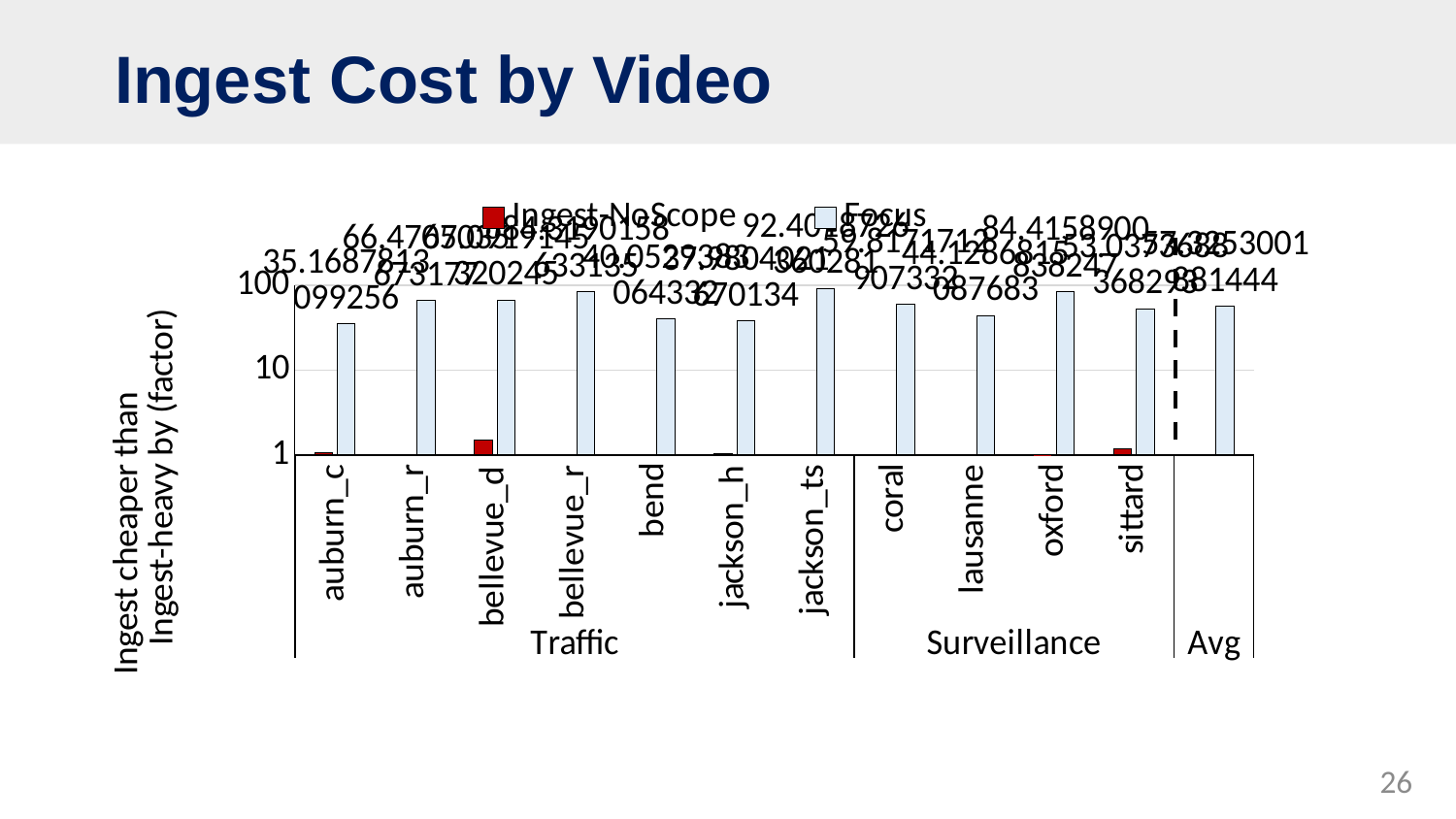
Is the Focus value for auburn_c greater or less than 100? less Which has the larger Focus value, auburn_r or auburn_c? auburn_r What are the two series named in the legend? Ingest-NoScope and Focus Is the Focus value for jackson_ts greater or less than 10? greater How many videos are in the Traffic group? 7 What is the label on the y axis? Ingest cheaper than Ingest-heavy by (factor) How many categories are shown along the x axis, including Avg? 12 What kind of chart is shown on the slide? bar chart How many series does the legend list? 2 How many videos are in the Surveillance group? 4 Which has the larger Focus value, jackson_ts or bend? jackson_ts Is the Ingest-NoScope value for auburn_r greater or less than 10? less